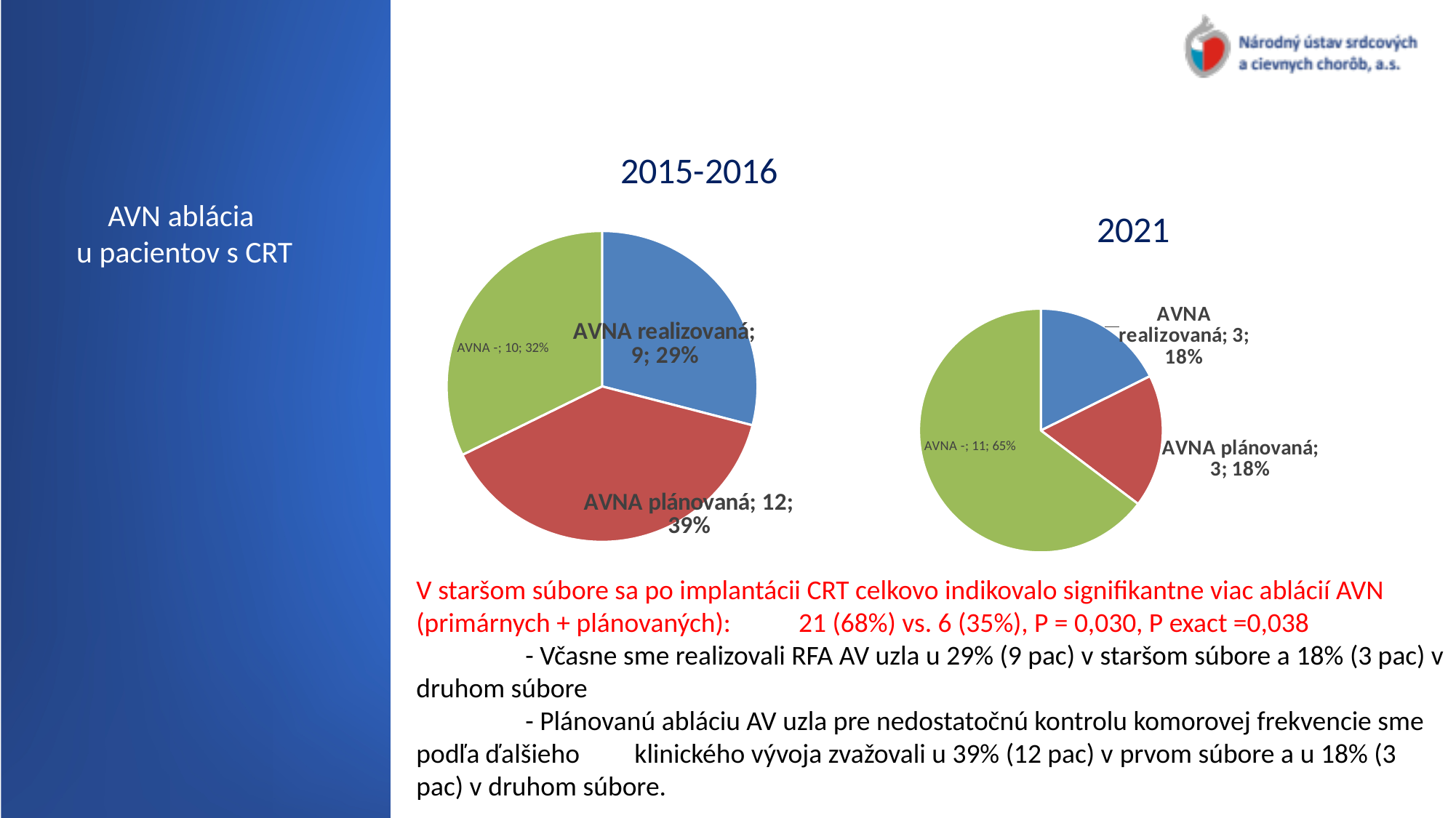
In the 2015-2016 chart, which category has the largest slice? AVNA plánovaná In the 2021 chart, which category has the largest slice? AVNA - What kind of chart is used for the 2021 data? Pie chart In the 2015-2016 chart, what percentage share does 'AVNA realizovaná' have? 29% In the 2015-2016 chart, how many patients are in the 'AVNA plánovaná' slice? 12 In the 2021 chart, how many patients are in the 'AVNA realizovaná' slice? 3 How many slices does the 2015-2016 chart have? 3 In the 2015-2016 chart, which category has the smallest slice? AVNA realizovaná In the 2015-2016 chart, what is the count for the 'AVNA -' slice? 10 In the 2021 chart, what percentage share does 'AVNA -' have? 65% In the 2021 chart, what is the total number of patients across all slices? 17 In the 2015-2016 chart, what is the difference in patient count between 'AVNA plánovaná' and 'AVNA realizovaná'? 3